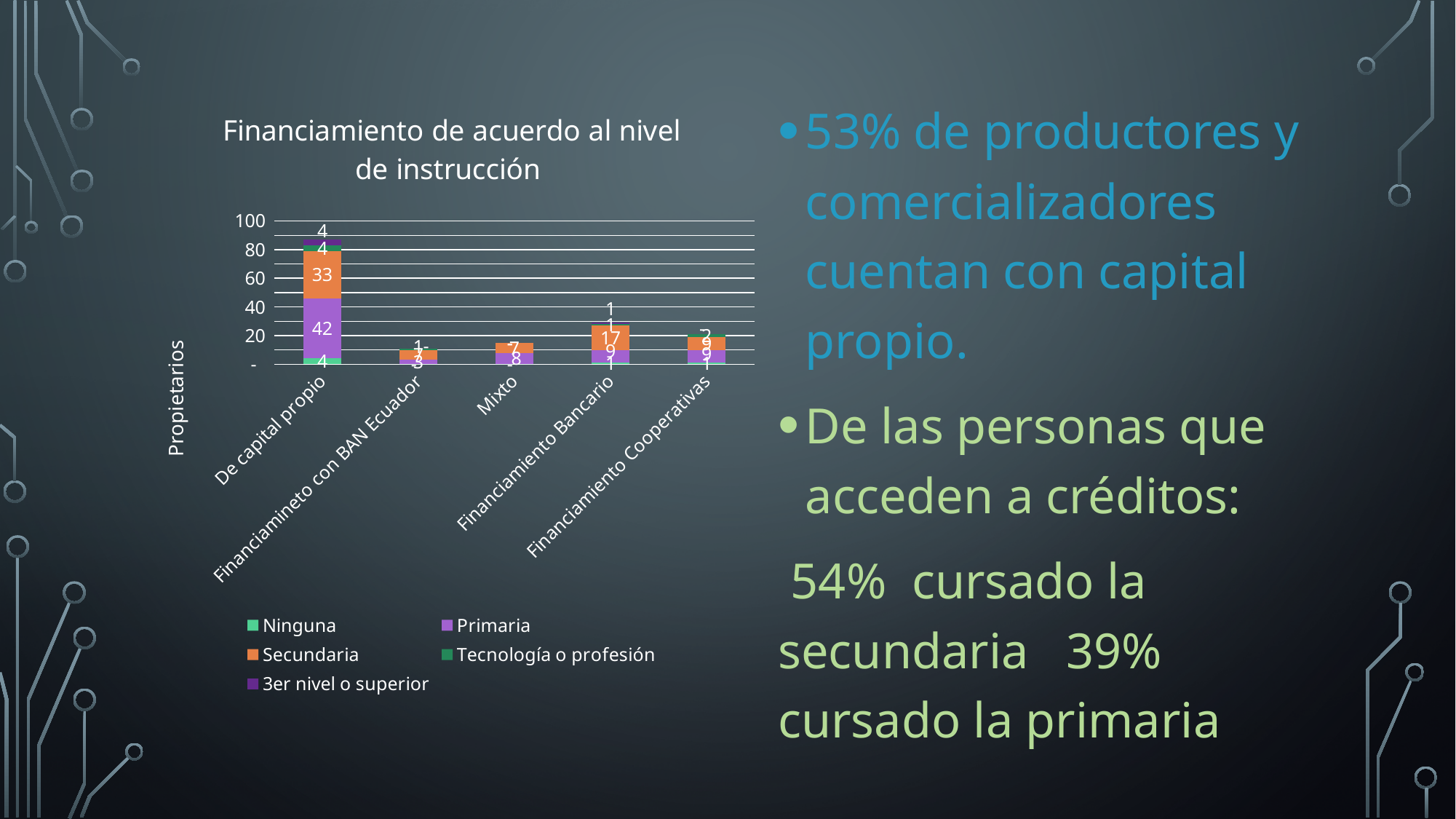
What is the difference between the Primaria and Secundaria values for De capital propio? 9 Is the total stacked value for De capital propio greater or less than 80? greater What is the Secundaria value for De capital propio? 33 What is the Primaria value for De capital propio? 42 What is the title of the chart? Financiamiento de acuerdo al nivel de instrucción What is the Primaria value for Mixto? 8 What kind of chart is shown on the slide? stacked bar chart What is the Secundaria value for Financiamiento Bancario? 17 How many series does the chart legend list? 5 Which financing category has the tallest stacked bar? De capital propio How many financing categories are shown on the x axis? 5 Which financing category has the shortest stacked bar? Financiamineto con BAN Ecuador